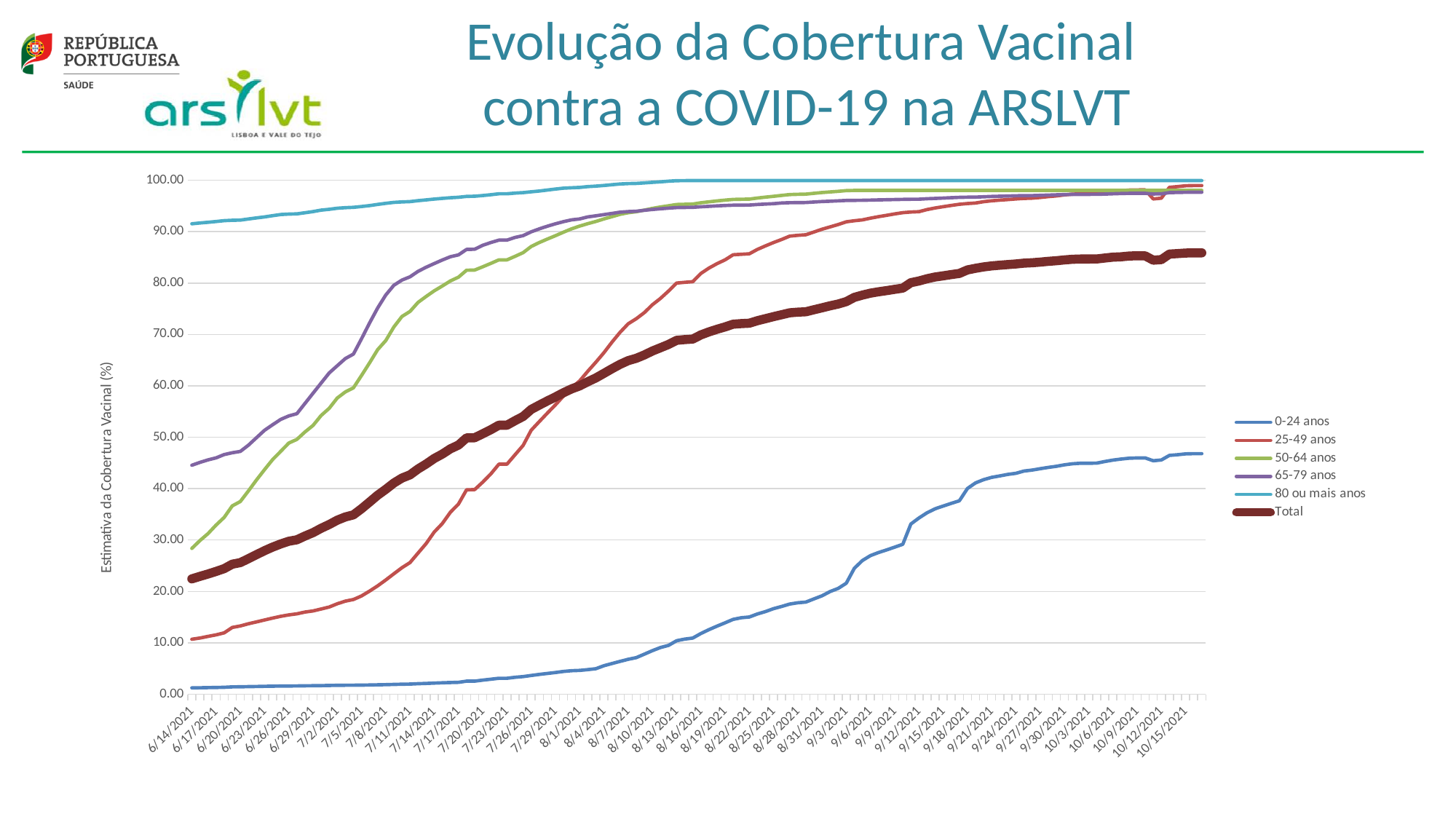
Is the value for Total at 10/15/2021 greater or less than 80.00? greater Is the value for 25-49 anos at 6/14/2021 greater or less than 20.00? less Do the values of the Total series rise or fall along the x axis? rise What kind of chart is shown on the slide? line chart How many series does the legend list? 6 Which series has the highest value at 6/14/2021? 80 ou mais anos Which series has the lowest value at 10/15/2021? 0-24 anos At 6/29/2021, which is higher: 65-79 anos or 50-64 anos? 65-79 anos Is the value for 80 ou mais anos at 6/14/2021 greater or less than 90.00? greater Which series is drawn with the thickest line? Total What is the title of the chart on the slide? Evolução da Cobertura Vacinal contra a COVID-19 na ARSLVT